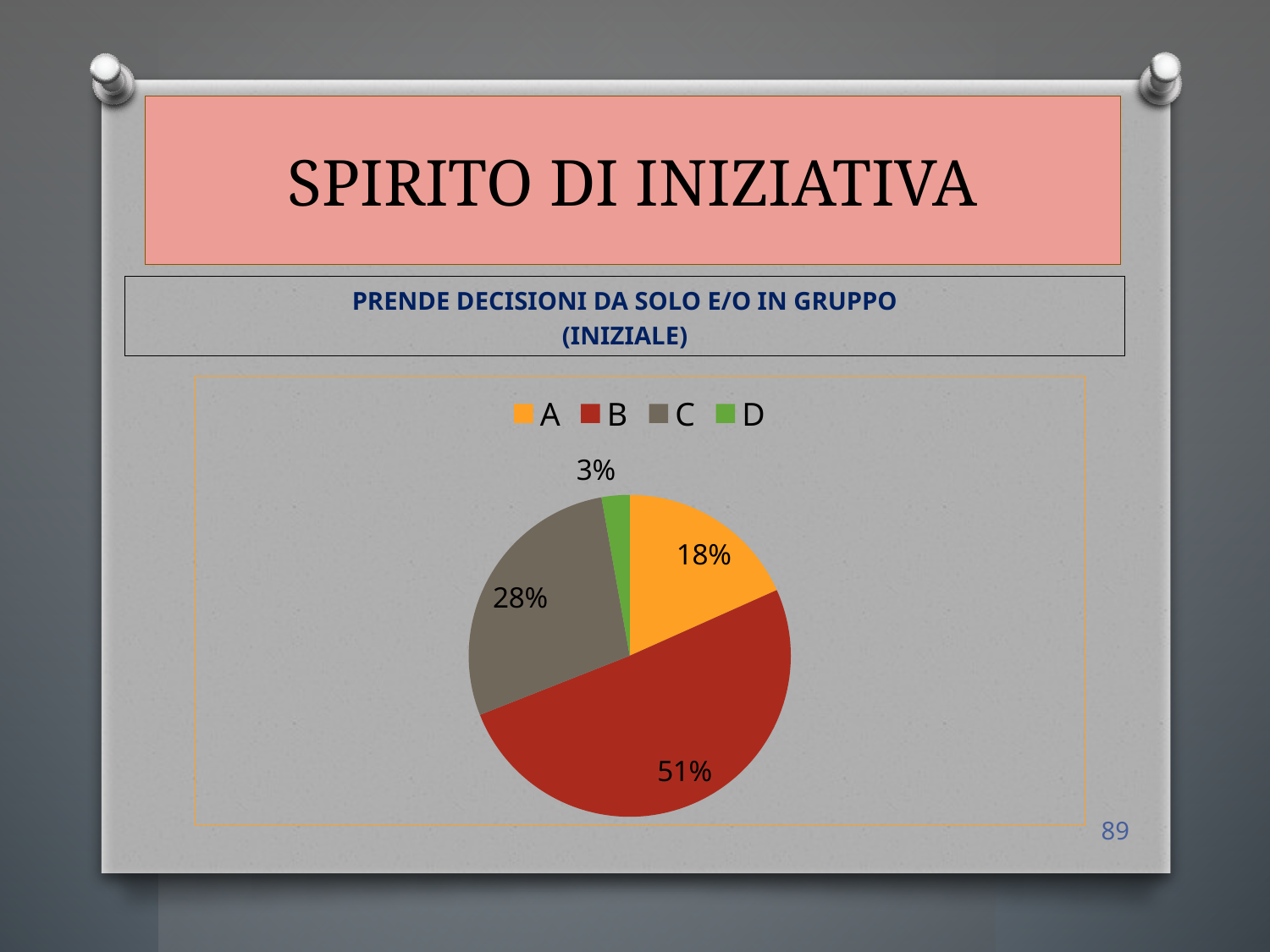
Which is larger, the share for A or the share for C? C How many categories does the legend list? 4 What colour is the slice for category B? red What percentage does slice D represent? 3% What is the difference in percentage points between B and C? 23 Which category has the smallest share of the pie? D What percentage does slice B represent? 51% Which category has the largest share of the pie? B How many slices does the pie chart have? 4 What percentage does slice C represent? 28% What kind of chart is shown on the slide? pie chart What percentage does slice A represent? 18%